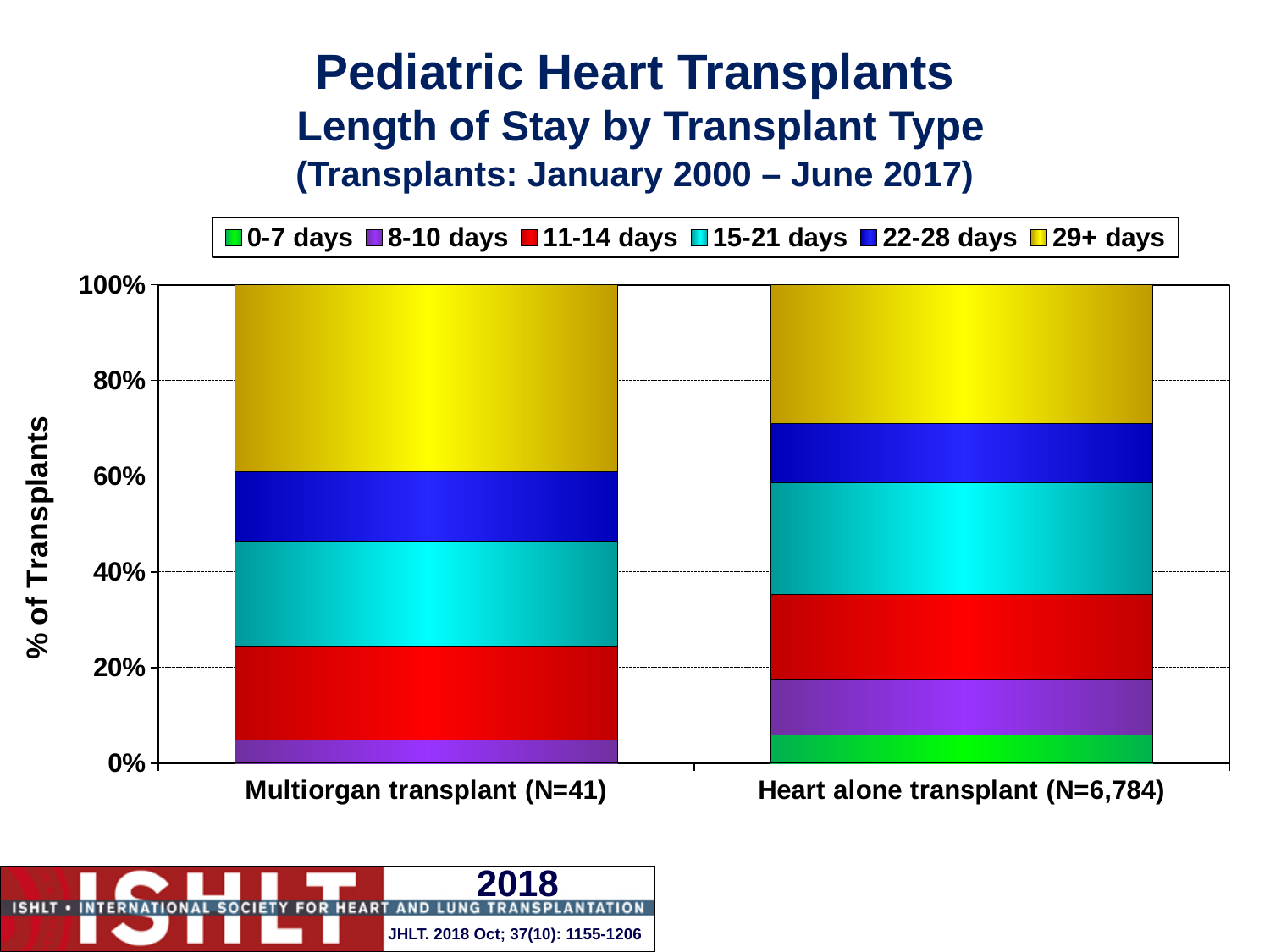
Which transplant type has the larger 8-10 days share, Multiorgan transplant or Heart alone transplant? Heart alone transplant Is the 8-10 days share for Multiorgan transplant greater or less than 20%? less Which transplant type has the larger 29+ days share, Multiorgan transplant or Heart alone transplant? Multiorgan transplant Is the 0-7 days share for Heart alone transplant greater or less than 20%? less What kind of chart is shown on the slide? Stacked bar chart Which length-of-stay segment is the largest in the Heart alone transplant bar? 29+ days Which length-of-stay segment is the smallest visible segment in the Heart alone transplant bar? 0-7 days Is the 29+ days share for Multiorgan transplant greater or less than 20%? greater How many length-of-stay series does the legend list? 6 How many transplant-type categories are shown on the x axis? 2 What is the N shown for the Heart alone transplant category? N=6,784 Which length-of-stay segment is the largest in the Multiorgan transplant bar? 29+ days